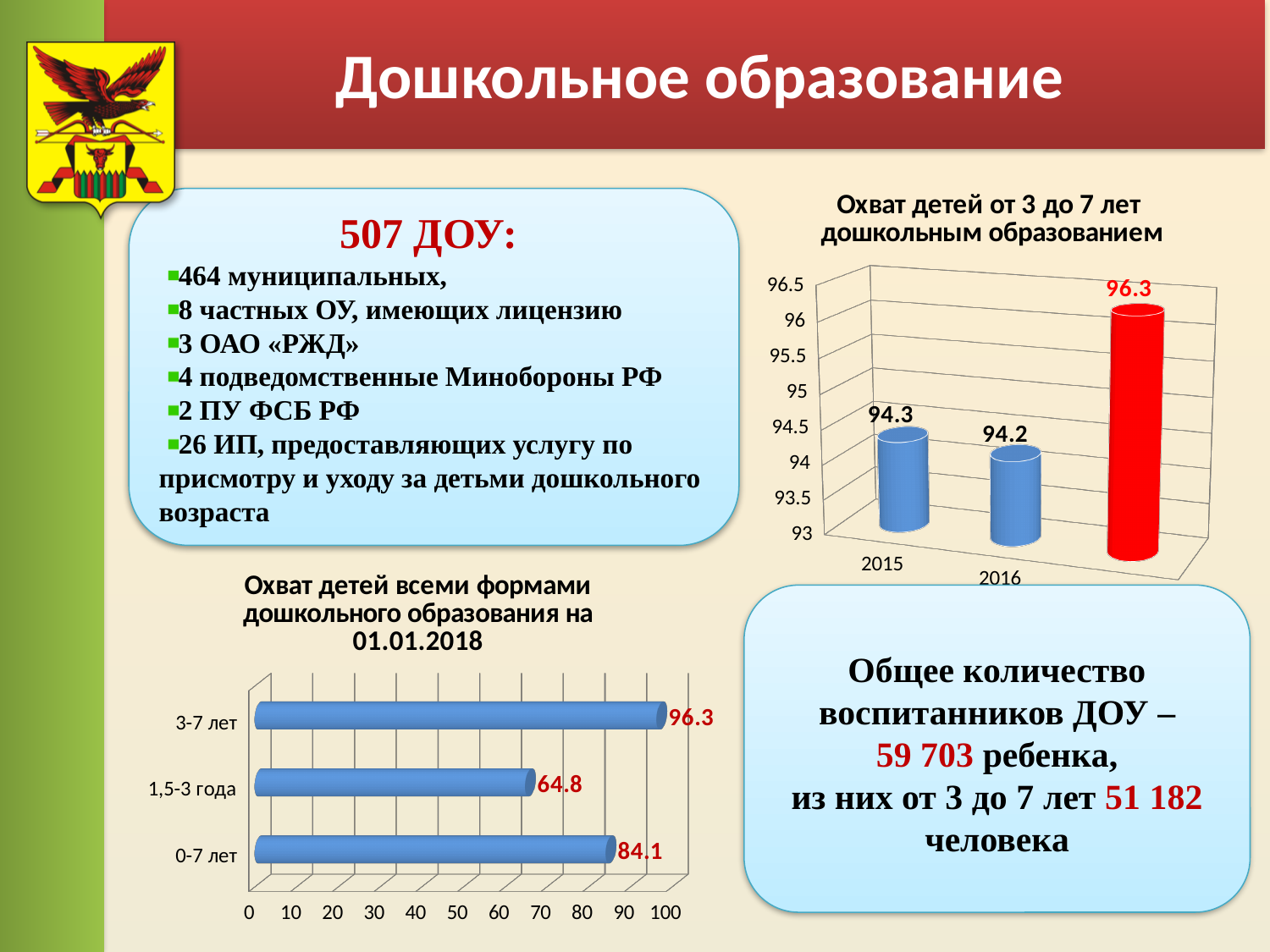
In the chart 'Охват детей всеми формами дошкольного образования на 01.01.2018', what is the value for 1,5-3 года? 64.8 In the chart 'Охват детей от 3 до 7 лет дошкольным образованием', what colour is the tallest bar? Red In the chart 'Охват детей всеми формами дошкольного образования на 01.01.2018', which category has the lowest value? 1,5-3 года In the chart 'Охват детей всеми формами дошкольного образования на 01.01.2018', how many categories are shown? 3 In the chart 'Охват детей всеми формами дошкольного образования на 01.01.2018', what is the difference between the values for 3-7 лет and 0-7 лет? 12.2 In the chart 'Охват детей всеми формами дошкольного образования на 01.01.2018', what is the value for 0-7 лет? 84.1 In the chart 'Охват детей от 3 до 7 лет дошкольным образованием', what is the highest value shown? 96.3 What kind of chart is 'Охват детей всеми формами дошкольного образования на 01.01.2018'? Bar chart In the chart 'Охват детей от 3 до 7 лет дошкольным образованием', what is the value for 2016? 94.2 In the chart 'Охват детей всеми формами дошкольного образования на 01.01.2018', what is the value for 3-7 лет? 96.3 In the chart 'Охват детей от 3 до 7 лет дошкольным образованием', how many bars are plotted? 3 In the chart 'Охват детей от 3 до 7 лет дошкольным образованием', what is the value for 2015? 94.3